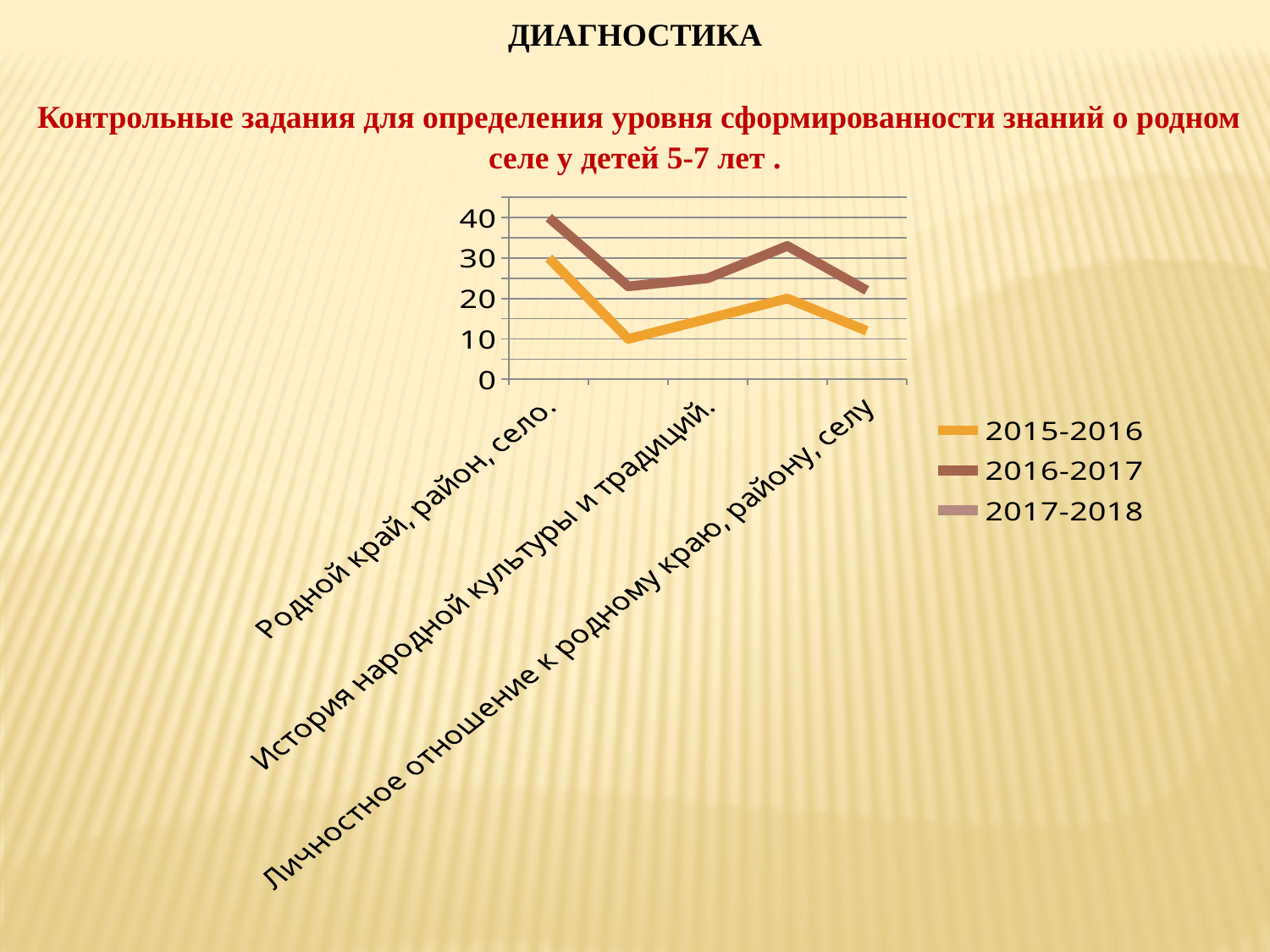
How many series does the legend list? 3 How many categories are labelled on the x axis? 3 What kind of chart is shown on the slide? line chart Is the 2015-2016 value for 'История народной культуры и традиций.' greater or less than 20? less Is the 2015-2016 value for 'Родной край, район, село.' greater or less than 20? greater Which series are listed in the legend? 2015-2016, 2016-2017, 2017-2018 For the 2016-2017 series, which labelled category has the highest value? Родной край, район, село. Is the 2016-2017 value for 'Родной край, район, село.' greater or less than 30? greater Which colour is used for the 2015-2016 series? orange For 'Родной край, район, село.', which series has the higher value, 2015-2016 or 2016-2017? 2016-2017